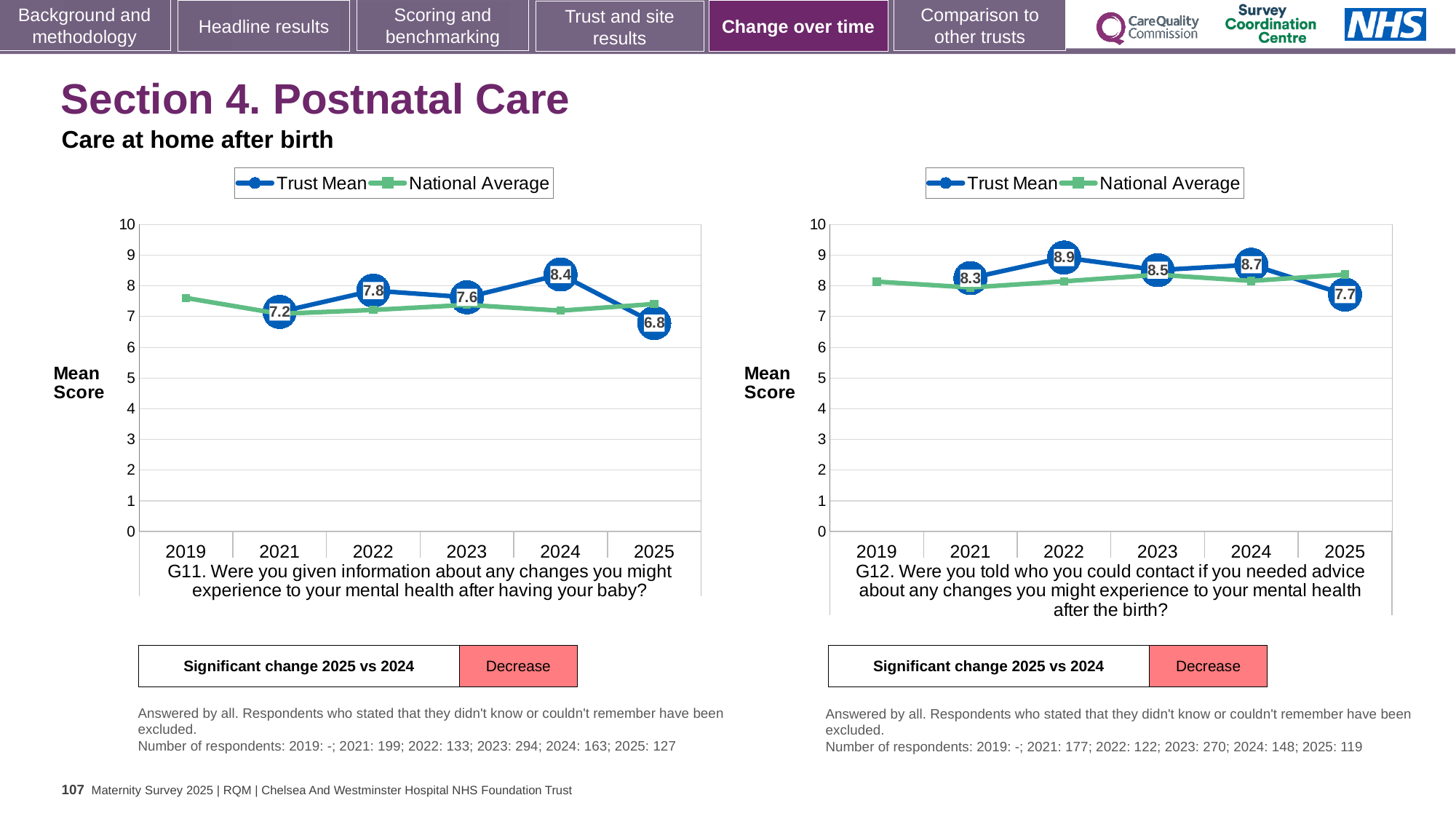
In the left chart (G11), is the National Average value for 2019 greater or less than 7? greater In the right chart (G12), what is the Trust Mean for 2022? 8.9 How many series does the legend of the left chart (G11) list? 2 In the left chart (G11), which year has the lowest Trust Mean? 2025 In the right chart (G12), what is the difference between the Trust Mean in 2022 and in 2025? 1.2 What type of chart is the right chart (G12)? Line chart In the right chart (G12), which year has the highest Trust Mean? 2022 In the left chart (G11), is the Trust Mean higher in 2022 or in 2023? 2022 In the left chart (G11), what is the Trust Mean for 2024? 8.4 In the right chart (G12), does the Trust Mean rise or fall from 2024 to 2025? Fall How many years are shown on the x axis of the right chart (G12)? 6 In the left chart (G11), what is the difference between the Trust Mean in 2024 and in 2025? 1.6